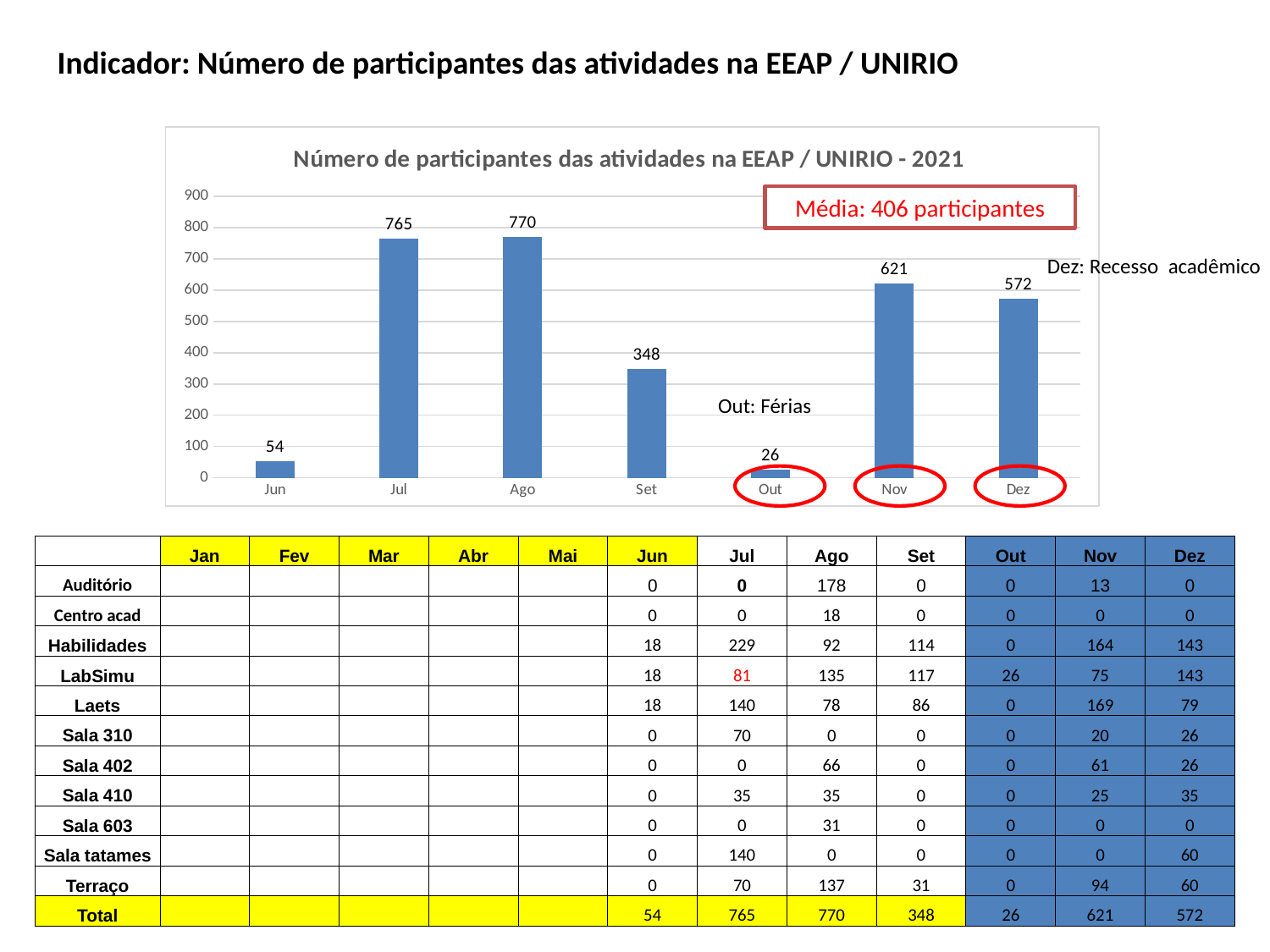
What is the value for Out in the chart? 26 What is the value for Nov in the chart? 621 What is the value for Jul in the chart? 765 What kind of chart is shown on the slide? bar chart What is the difference between the values for Nov and Dez in the chart? 49 Which is larger in the chart, the value for Set or the value for Dez? Dez Which month has the lowest value in the chart? Out What is the difference between the values for Jul and Set in the chart? 417 Is the value for Jun in the chart greater or less than 100? less What average (Média) is stated in the annotation box on the chart? 406 participantes Which month has the highest value in the chart? Ago How many months are plotted in the chart? 7